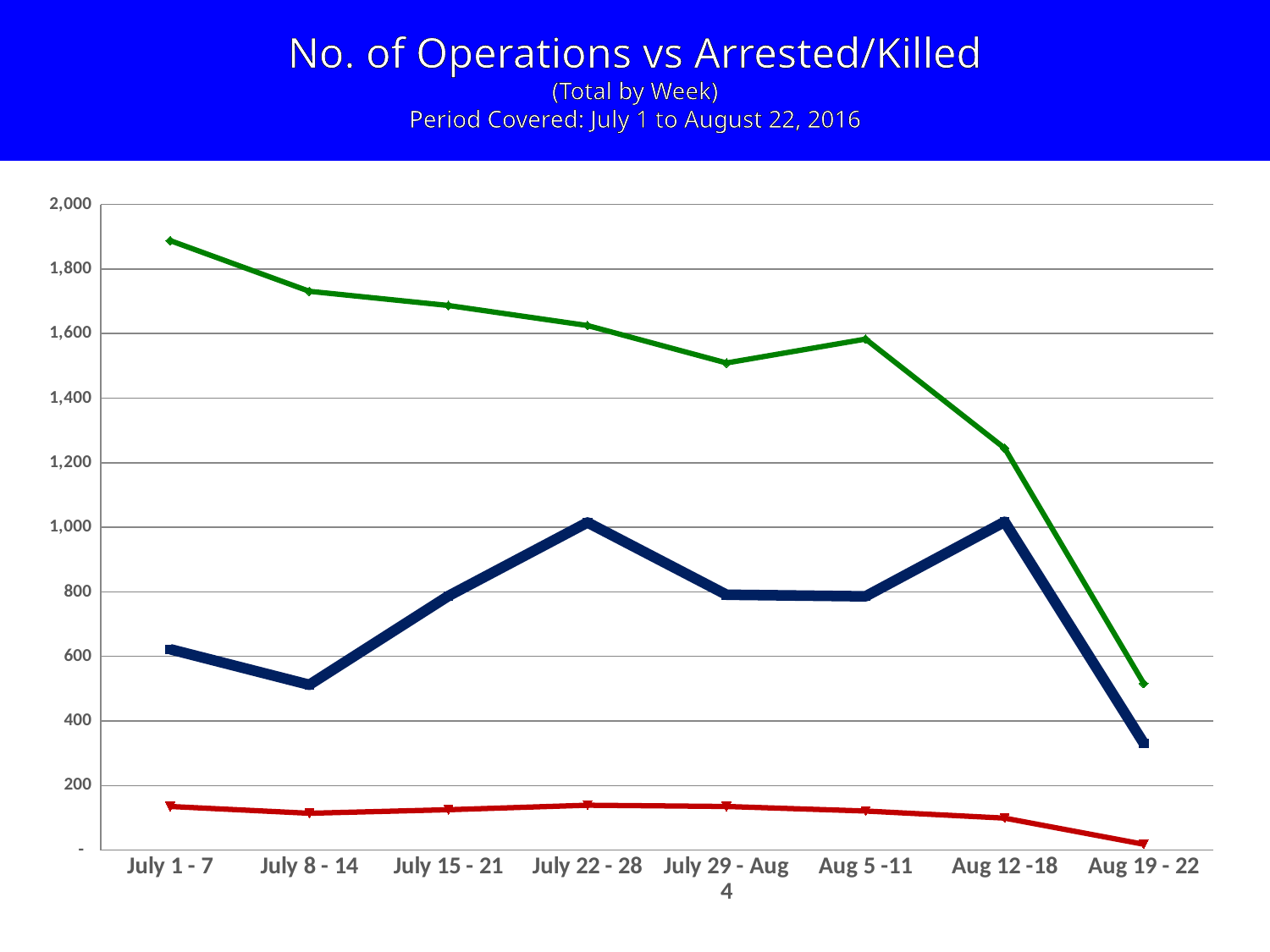
Does the green line generally rise or fall from July 1 - 7 to Aug 19 - 22? fall In which week does the green line reach its highest value? July 1 - 7 What type of chart is shown on the slide? line chart Is the value of the green line for July 1 - 7 greater or less than 1,800? greater In which week does the dark blue line reach its lowest value? Aug 19 - 22 How many weekly periods are shown on the x axis? 8 Is the value of the red line for July 22 - 28 greater or less than 200? less For July 22 - 28, which line has the larger value, the green line or the dark blue line? green line In which week does the green line reach its lowest value? Aug 19 - 22 How many lines are plotted on the chart? 3 Is the value of the dark blue line for July 8 - 14 greater or less than 600? less